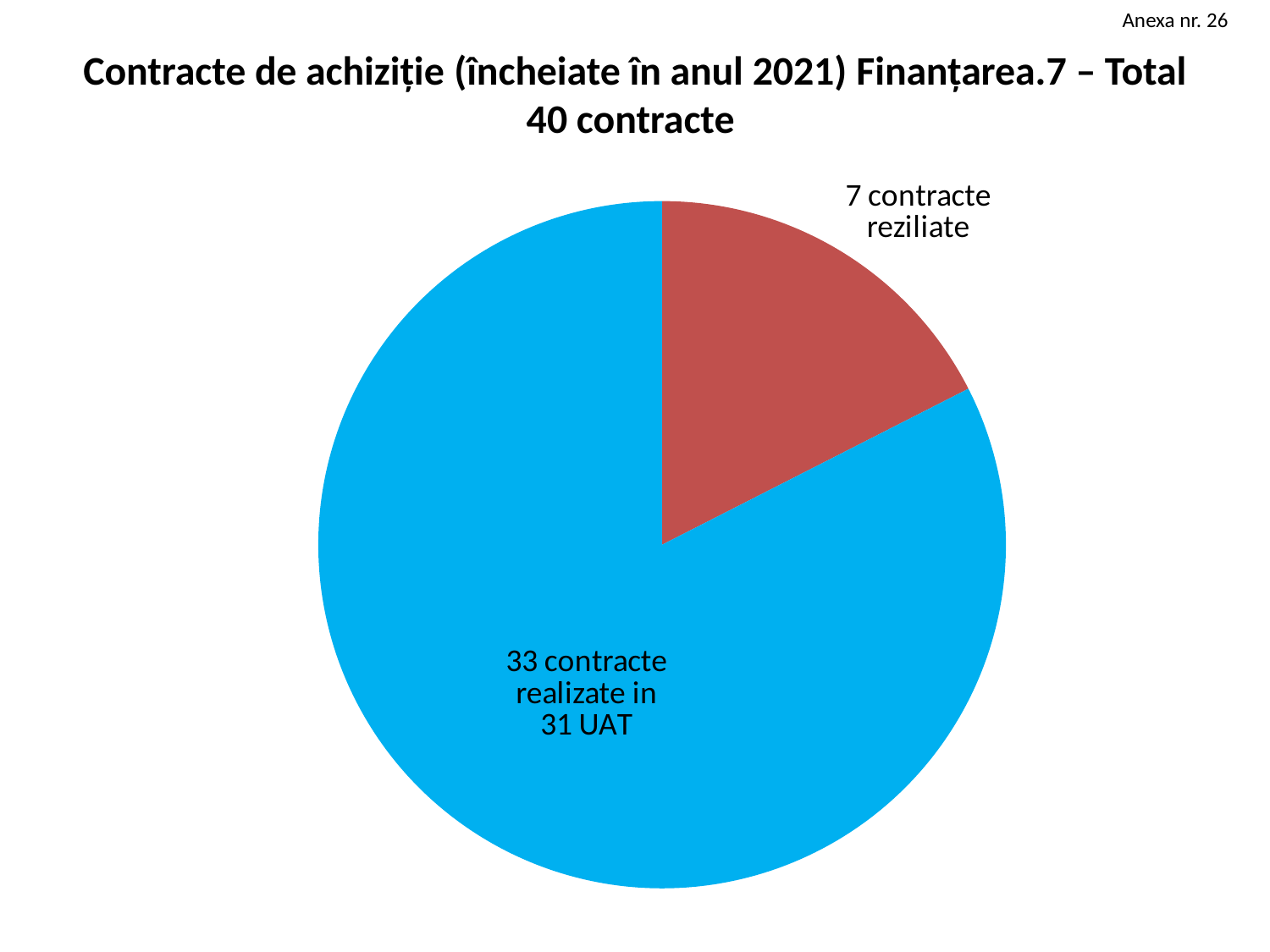
Which slice is the largest? 33 contracte realizate in 31 UAT What is the difference between the number of contracts realized and the number of contracts terminated (reziliate)? 26 Which is larger: the number of contracts realized or the number of contracts terminated (reziliate)? contracte realizate What is the total number of contracts shown in the chart? 40 What kind of chart is shown on the slide? pie chart How many contracts are labelled as 'contracte reziliate'? 7 How many contracts are labelled as 'contracte realizate in 31 UAT'? 33 What colour is the slice for the terminated (reziliate) contracts? red Which slice is the smallest? 7 contracte reziliate What share of the total contracts do the 7 terminated (reziliate) contracts represent? 17.5% How many slices does the pie chart have? 2 What is the title of the chart? Contracte de achiziție (încheiate în anul 2021) Finanțarea.7 – Total 40 contracte